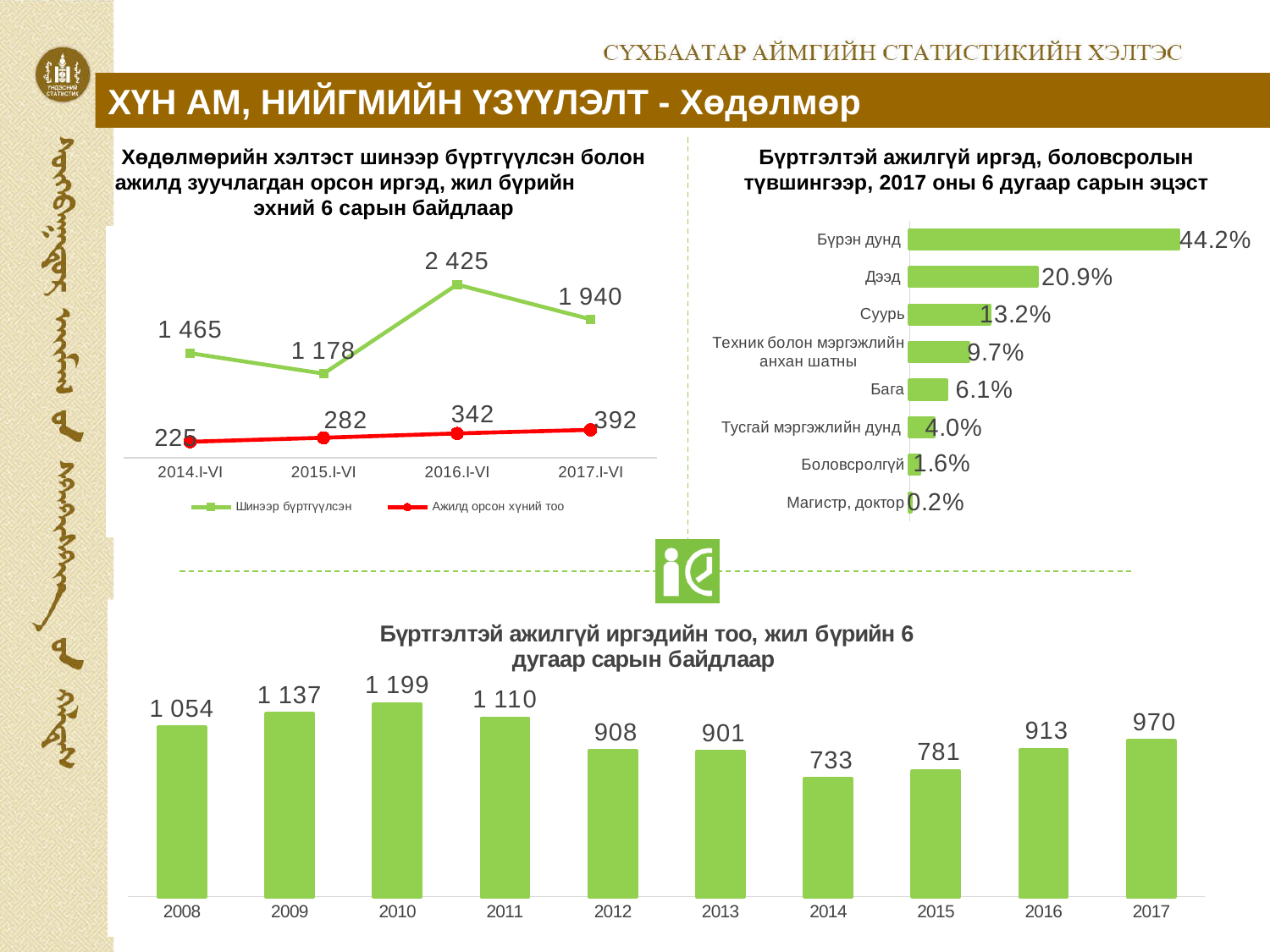
In the bottom chart (Бүртгэлтэй ажилгүй иргэдийн тоо), which year has the lowest value? 2014 In the top-right chart (Бүртгэлтэй ажилгүй иргэд, боловсролын түвшингээр), which category has the highest share? Бүрэн дунд In the top-left chart (Хөдөлмөрийн хэлтэст шинээр бүртгүүлсэн болон ажилд зуучлагдан орсон иргэд), what is the value of Ажилд орсон хүний тоо for 2017.I-VI? 392 In the bottom chart (Бүртгэлтэй ажилгүй иргэдийн тоо), which is larger, the value for 2012 or the value for 2016? 2016 In the top-left chart (Хөдөлмөрийн хэлтэст шинээр бүртгүүлсэн болон ажилд зуучлагдан орсон иргэд), how many series does the legend list? 2 In the bottom chart (Бүртгэлтэй ажилгүй иргэдийн тоо), what is the value for 2010? 1 199 In the top-left chart (Хөдөлмөрийн хэлтэст шинээр бүртгүүлсэн болон ажилд зуучлагдан орсон иргэд), what is the value of Шинээр бүртгүүлсэн for 2016.I-VI? 2 425 In the top-right chart (Бүртгэлтэй ажилгүй иргэд, боловсролын түвшингээр), what kind of chart is it? bar chart In the top-left chart (Хөдөлмөрийн хэлтэст шинээр бүртгүүлсэн болон ажилд зуучлагдан орсон иргэд), does the Ажилд орсон хүний тоо series rise or fall from 2014.I-VI to 2017.I-VI? rise In the top-left chart (Хөдөлмөрийн хэлтэст шинээр бүртгүүлсэн болон ажилд зуучлагдан орсон иргэд), what is the difference between Шинээр бүртгүүлсэн and Ажилд орсон хүний тоо for 2015.I-VI? 896 In the top-right chart (Бүртгэлтэй ажилгүй иргэд, боловсролын түвшингээр), how many categories are shown? 8 In the top-right chart (Бүртгэлтэй ажилгүй иргэд, боловсролын түвшингээр), what is the value for Дээд? 20.9%